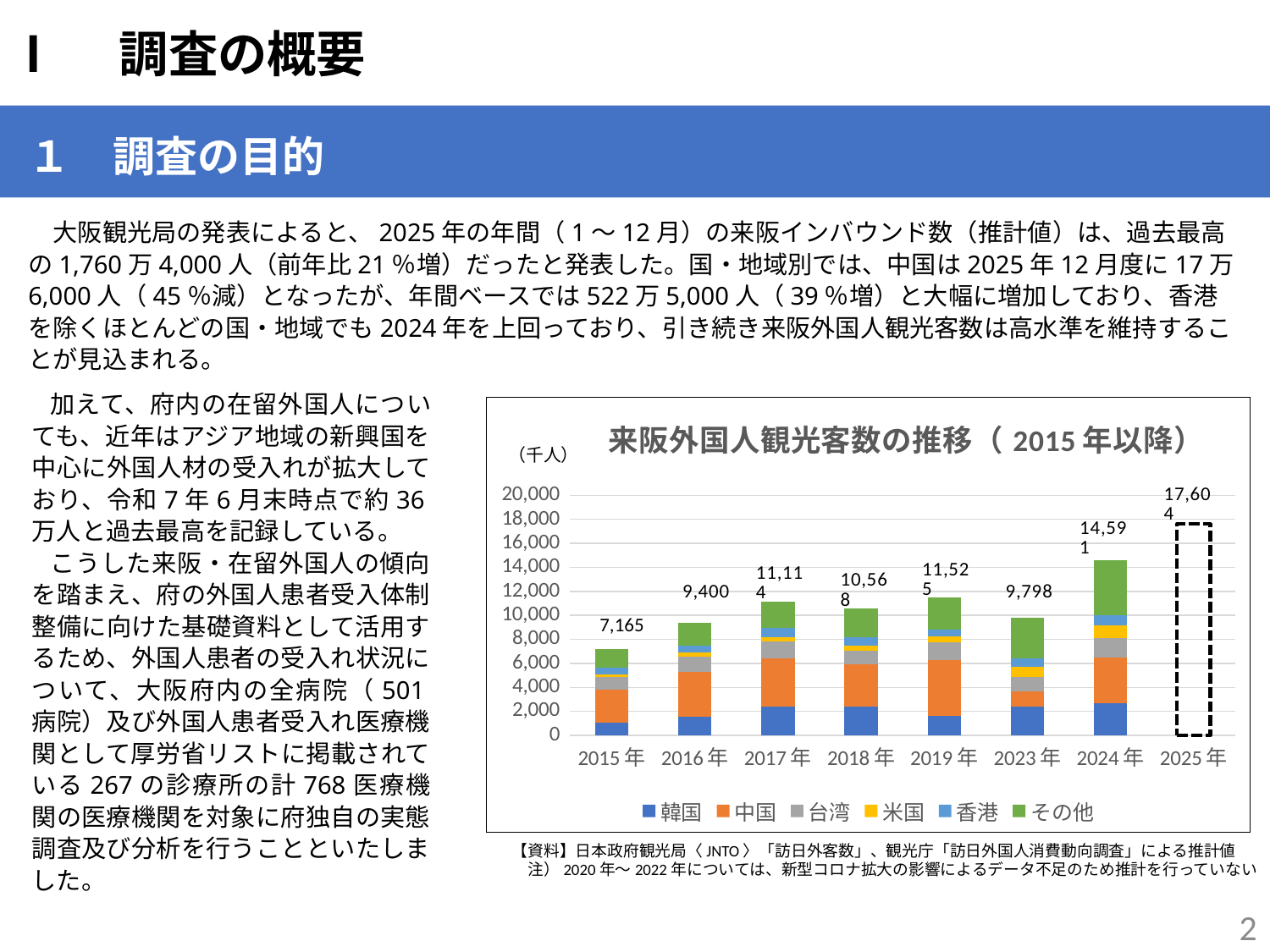
What is the title of the chart? 来阪外国人観光客数の推移（2015年以降） Which year has the highest total value? 2025年 What is the difference between the total for 2025年 and the total for 2024年? 3,013 What is the total value labeled for 2025年? 17,604 Which year has the lowest total value? 2015年 What is the total value labeled for 2015年? 7,165 What is the total value labeled for 2024年? 14,591 Which is larger, the total for 2017年 or the total for 2018年? 2017年 How many years (categories) are plotted on the x axis? 8 How many series does the chart's legend list? 6 What kind of chart is shown on the slide? Stacked bar chart Do the total values rise or fall from 2023年 to 2025年? Rise